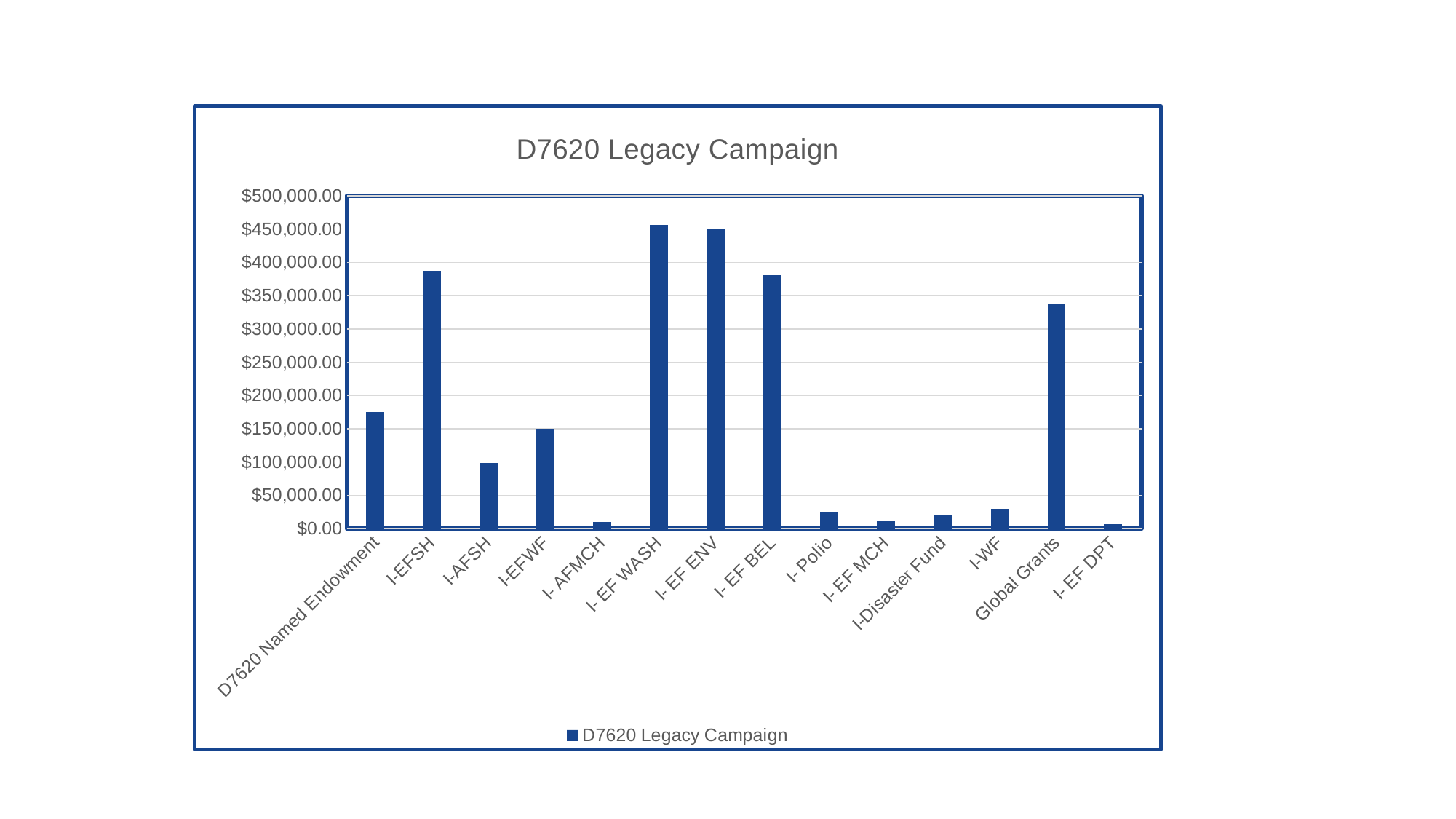
How many categories are plotted on the x axis? 14 Is the value for I- Polio greater or less than $50,000.00? less Which is larger, the value for Global Grants or the value for I- EF BEL? I- EF BEL How many series does the legend list? 1 Is the value for I- EF BEL greater or less than $350,000.00? greater What kind of chart is shown on the slide? bar chart Is the value for Global Grants greater or less than $300,000.00? greater Which is larger, the value for I-EFSH or the value for I-AFSH? I-EFSH What is the title of the chart? D7620 Legacy Campaign Which is larger, the value for D7620 Named Endowment or the value for I-EFWF? D7620 Named Endowment